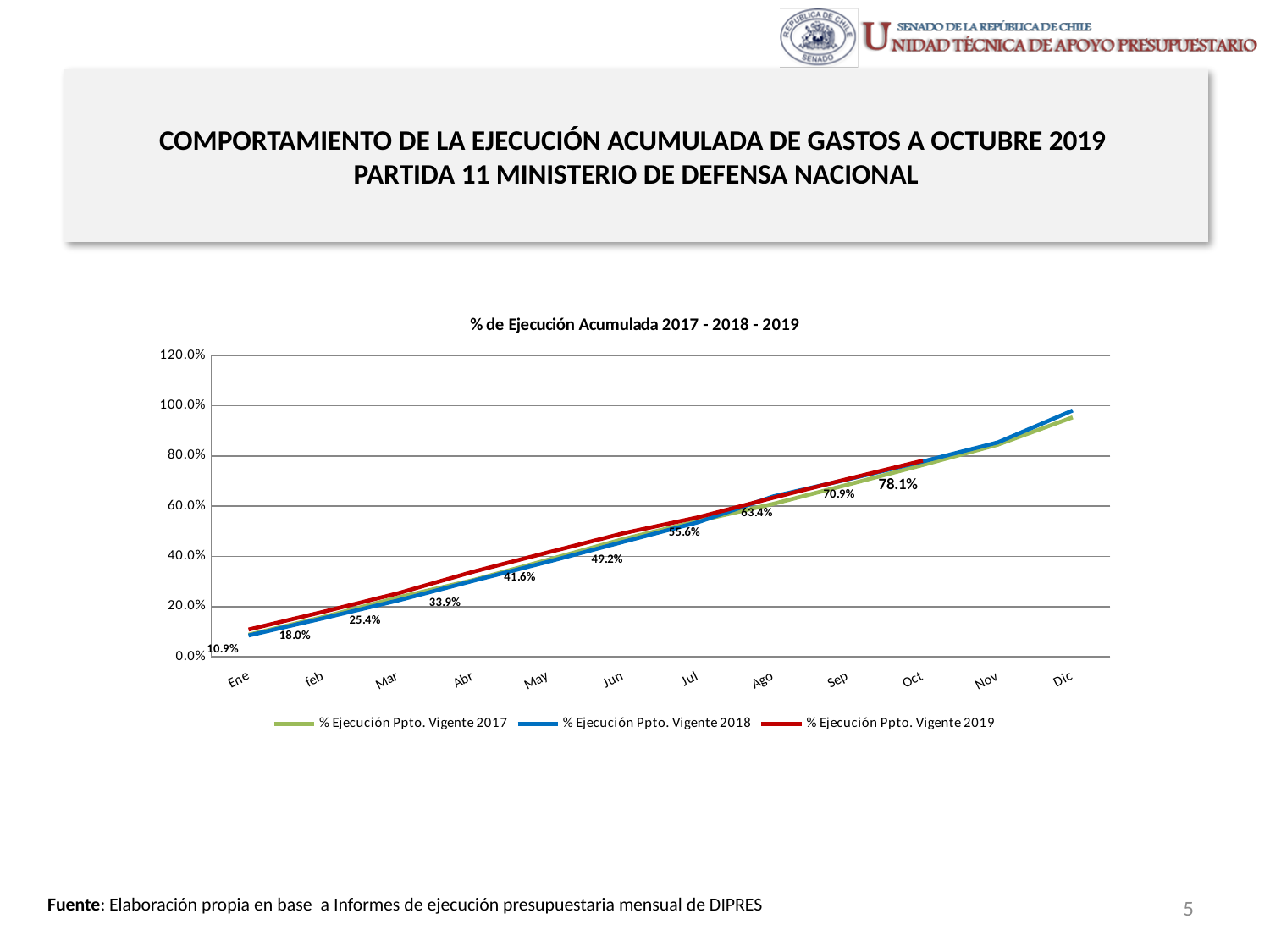
What is the value of % Ejecución Ppto. Vigente 2019 in Oct? 78.1% What is the value of % Ejecución Ppto. Vigente 2019 in Jun? 49.2% What is the title of the chart? % de Ejecución Acumulada 2017 - 2018 - 2019 What is the value of % Ejecución Ppto. Vigente 2019 in Ene? 10.9% What is the difference between the 2019 values for Ago and Jul? 7.8% What kind of chart is shown on the slide? line chart Is the value for % Ejecución Ppto. Vigente 2017 in Ene greater or less than 20.0%? less How many series does the legend list? 3 Does the % Ejecución Ppto. Vigente 2019 line rise or fall from Ene to Oct? rise How many months are shown along the x axis? 12 Is the value for % Ejecución Ppto. Vigente 2018 in Dic greater or less than 80.0%? greater What is the difference between the 2019 values for Oct and Sep? 7.2%